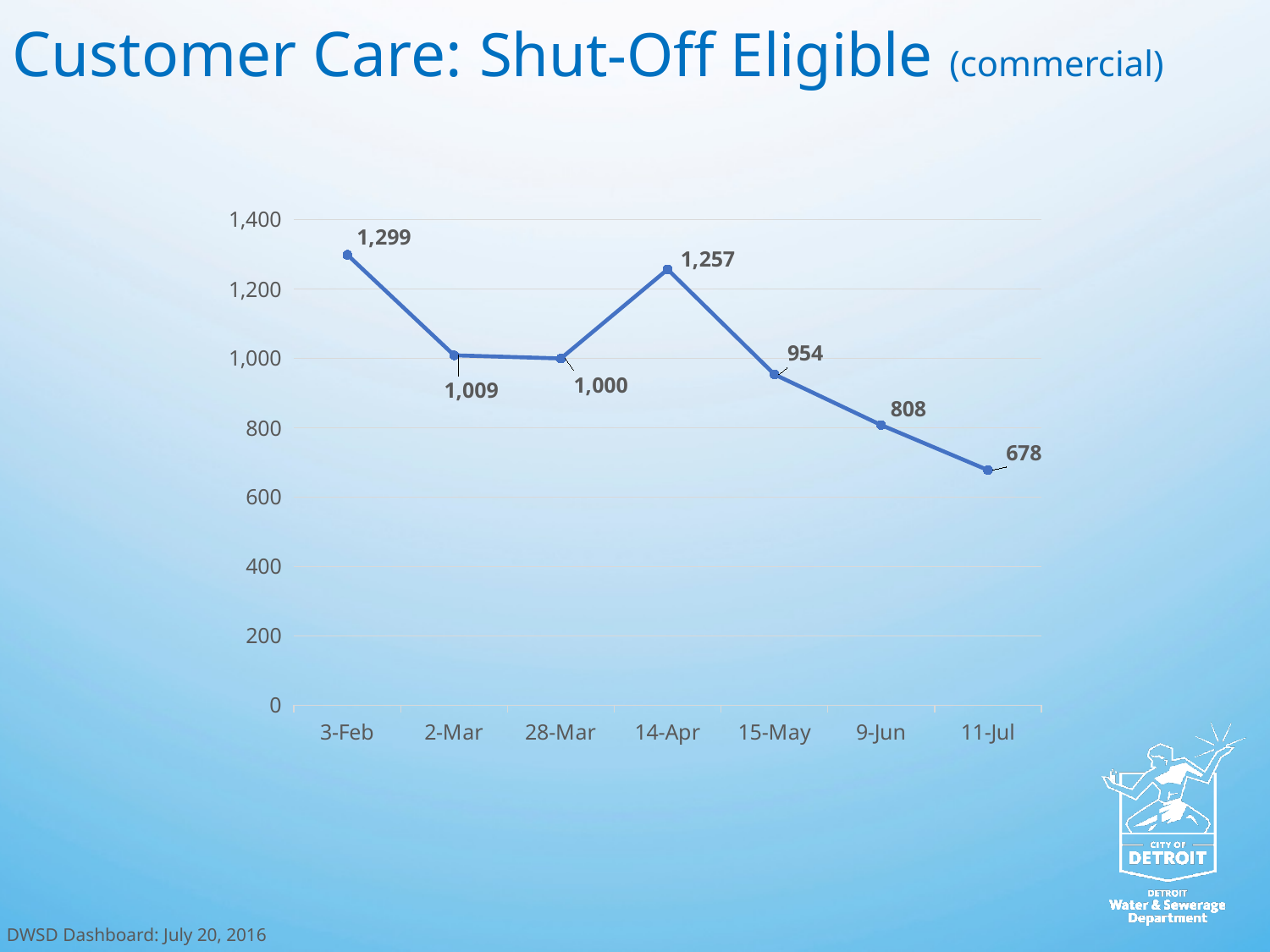
What is the value for 11-Jul? 678 What is the difference between the values for 3-Feb and 11-Jul? 621 What is the value for 3-Feb? 1,299 Which is larger, the value for 2-Mar or the value for 28-Mar? 2-Mar What is the difference between the values for 14-Apr and 15-May? 303 What kind of chart is shown on the slide? Line chart Which date has the highest value? 3-Feb Which date has the lowest value? 11-Jul Do the values rise or fall from 14-Apr to 11-Jul? Fall What is the value for 14-Apr? 1,257 How many data points are plotted on the chart? 7 What is the value for 9-Jun? 808